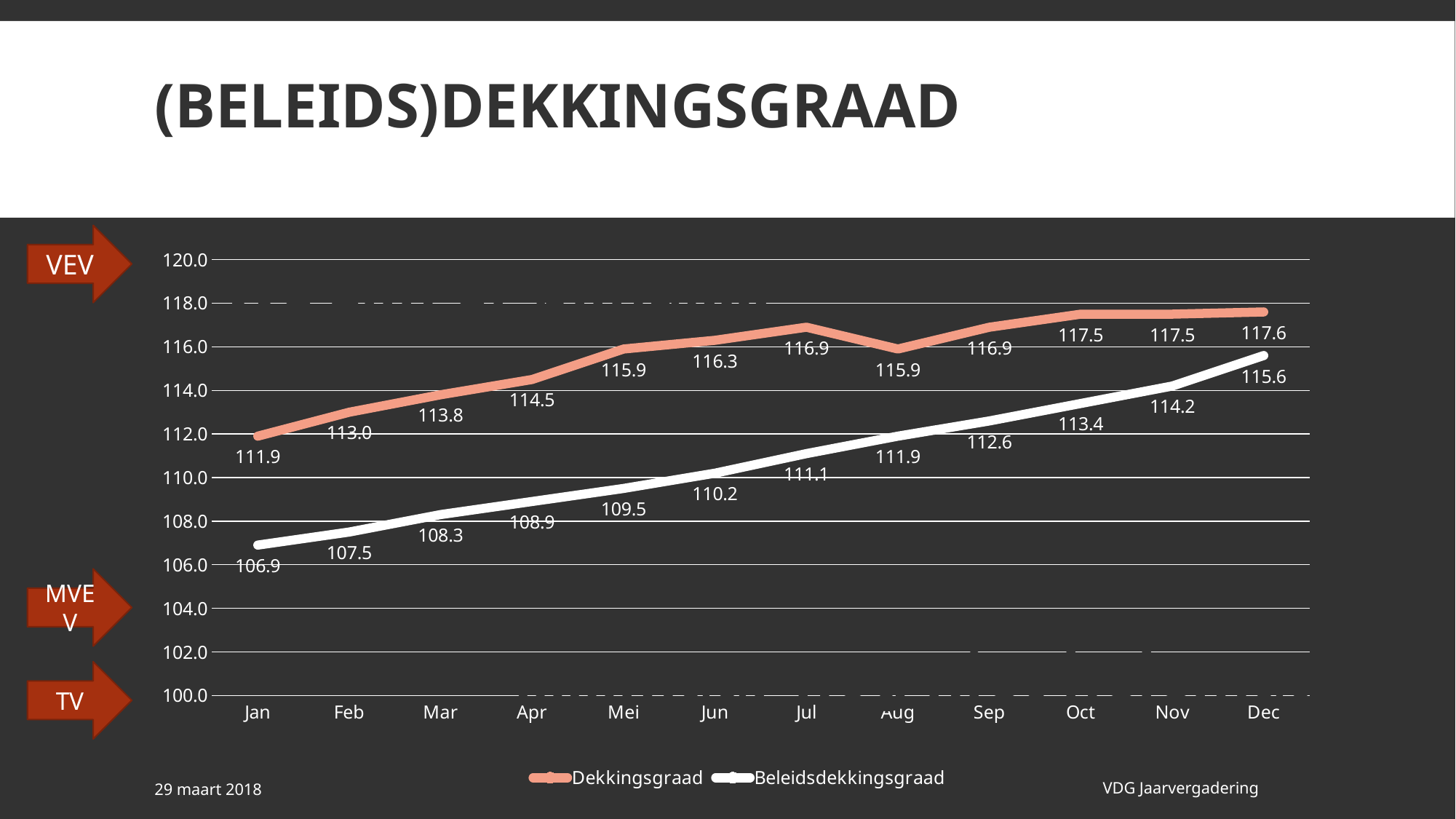
In which month is the Beleidsdekkingsgraad lowest? Jan What kind of chart is shown on the slide? Line chart Which is larger in Jul: the Dekkingsgraad or the Beleidsdekkingsgraad? Dekkingsgraad What is the Dekkingsgraad value for Aug? 115.9 What is the Beleidsdekkingsgraad value for Jun? 110.2 What is the Beleidsdekkingsgraad value for Dec? 115.6 How many series does the legend list? 2 In which month is the Dekkingsgraad highest? Dec How many months are shown on the x axis? 12 Does the Beleidsdekkingsgraad rise or fall from Jan to Dec? Rise What is the Dekkingsgraad value for Jan? 111.9 What is the difference between the Dekkingsgraad and the Beleidsdekkingsgraad in Dec? 2.0